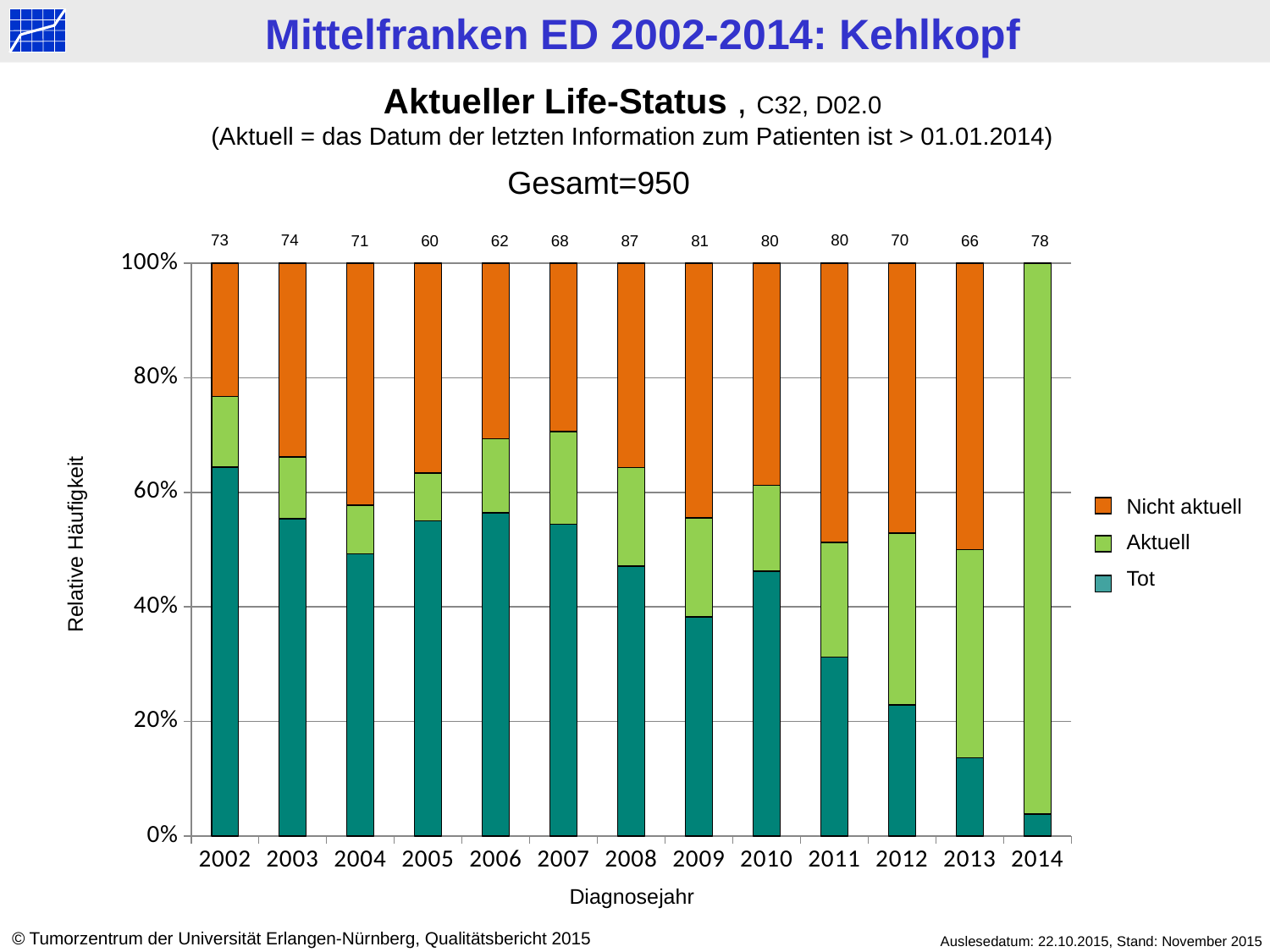
Which diagnosis year has the lowest number of cases printed above its bar? 2005 Which diagnosis year has the highest number of cases printed above its bar? 2008 What is the number of cases shown above the bar for 2005? 60 What kind of chart is shown on the slide? Stacked bar chart How many diagnosis years are shown on the x axis? 13 Is the 'Tot' share for 2002 greater or less than 60%? greater What is the difference between the number of cases for 2008 and for 2005? 27 What is the number of cases shown above the bar for 2014? 78 Which year has more cases printed above its bar, 2011 or 2012? 2011 Is the 'Tot' share for 2013 greater or less than 20%? less What is the number of cases shown above the bar for 2008? 87 How many series does the legend list? 3